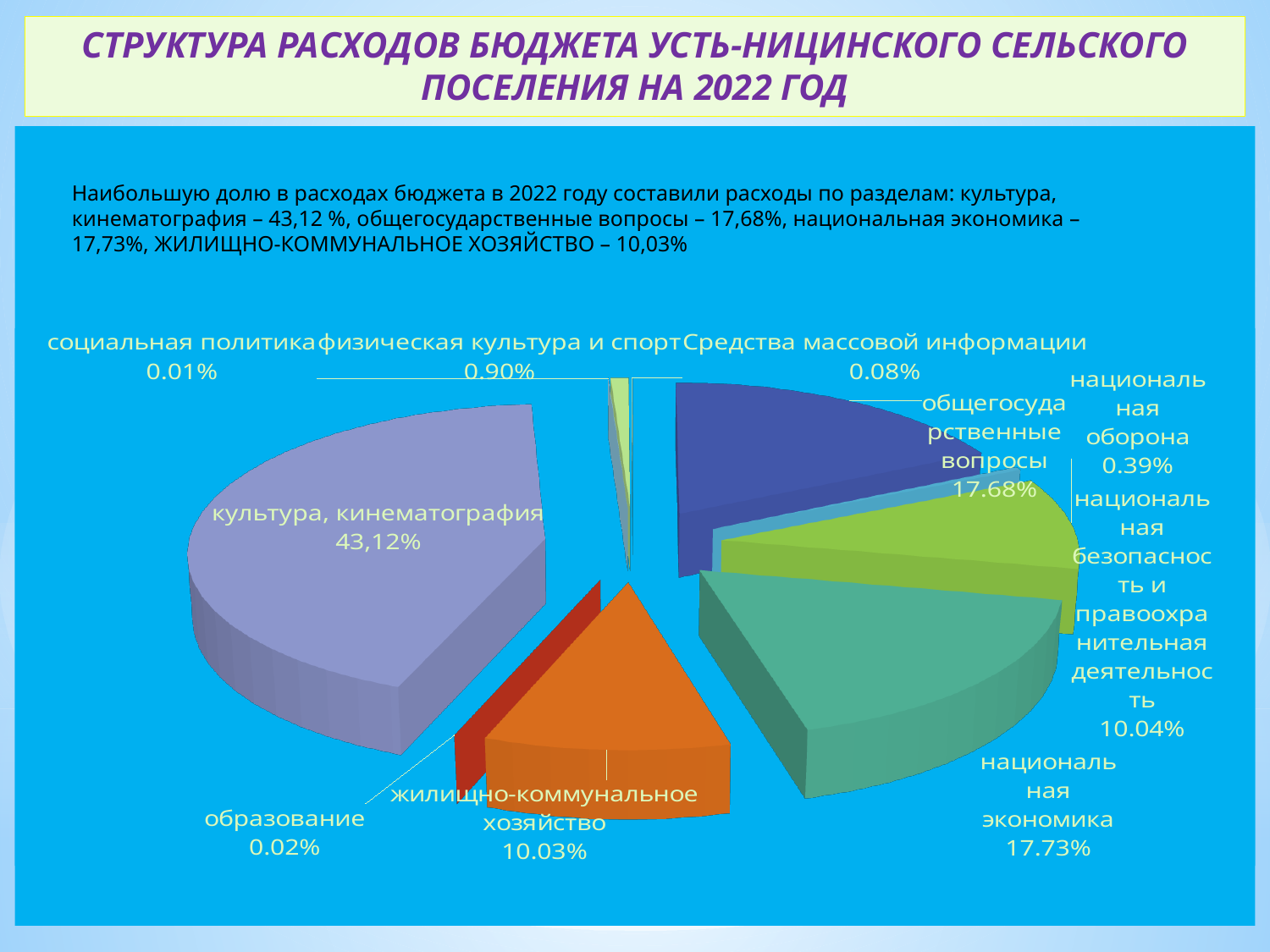
What is the value shown for национальная экономика? 17.73% What is the value shown for общегосударственные вопросы? 17.68% Which category has the largest share of the pie? культура, кинематография What kind of chart is shown on the slide? pie chart What is the difference between the shares for общегосударственные вопросы and национальная безопасность и правоохранительная деятельность? 7.64% How many categories are shown in the pie chart? 10 What share of the budget expenditure does культура, кинематография account for? 43,12% What is the value shown for национальная оборона? 0.39% Which category has the smallest share of the pie? социальная политика What is the value shown for жилищно-коммунальное хозяйство? 10.03% What is the value shown for физическая культура и спорт? 0.90% Which is larger: the share for культура, кинематография or the share for национальная экономика? культура, кинематография